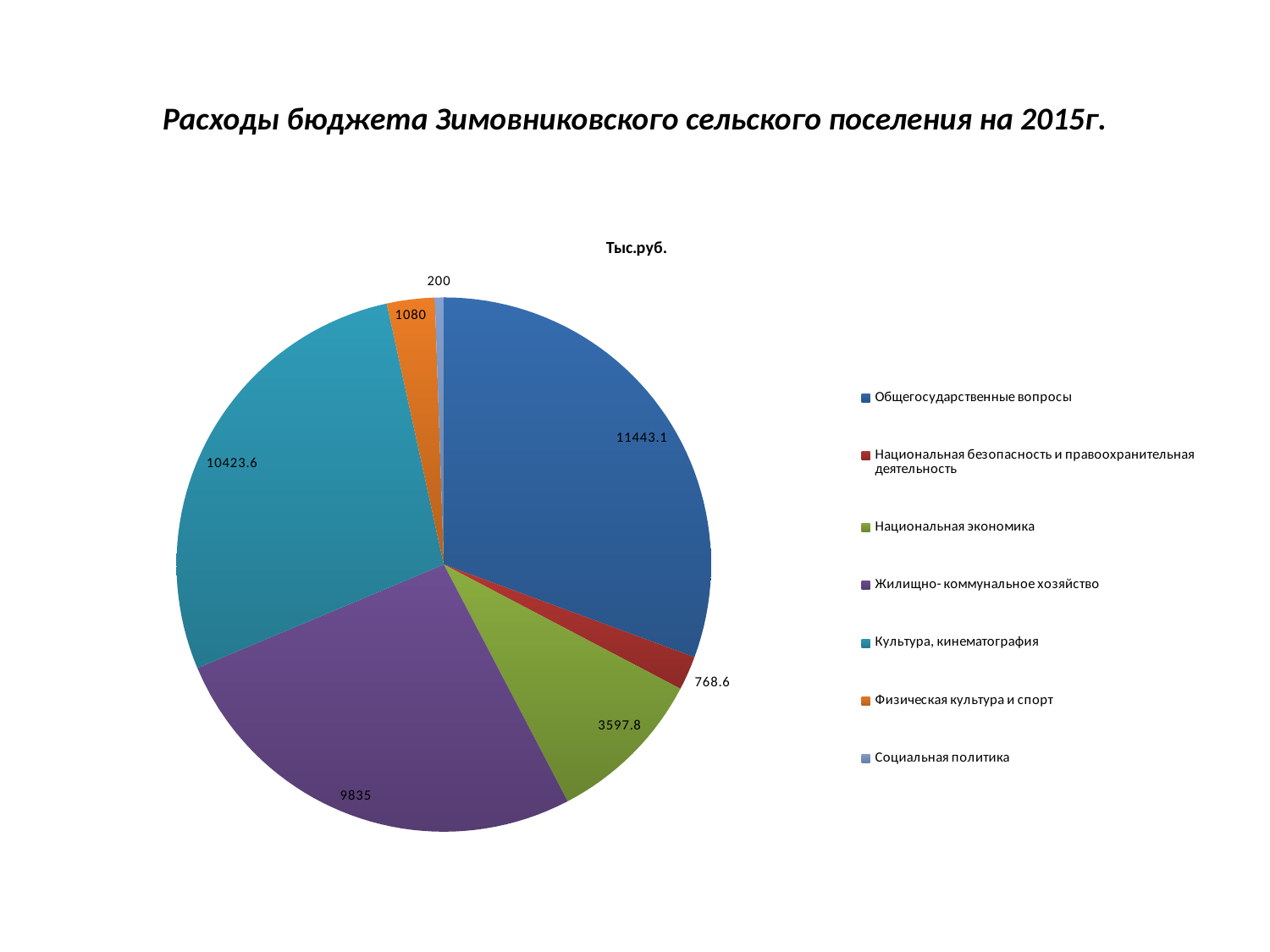
How many categories does the pie chart have? 7 Which is larger: the value for Культура, кинематография or the value for Жилищно- коммунальное хозяйство? Культура, кинематография What is the value for Национальная безопасность и правоохранительная деятельность? 768.6 Which category has the smallest value? Социальная политика What is the value for Общегосударственные вопросы? 11443.1 What type of chart is shown on the slide? Pie chart What is the value for Жилищно- коммунальное хозяйство? 9835 What is the title of the chart? Тыс.руб. What is the difference between the values for Жилищно- коммунальное хозяйство and Национальная экономика? 6237.2 What is the difference between the values for Общегосударственные вопросы and Культура, кинематография? 1019.5 What is the value for Физическая культура и спорт? 1080 Which category has the largest value? Общегосударственные вопросы